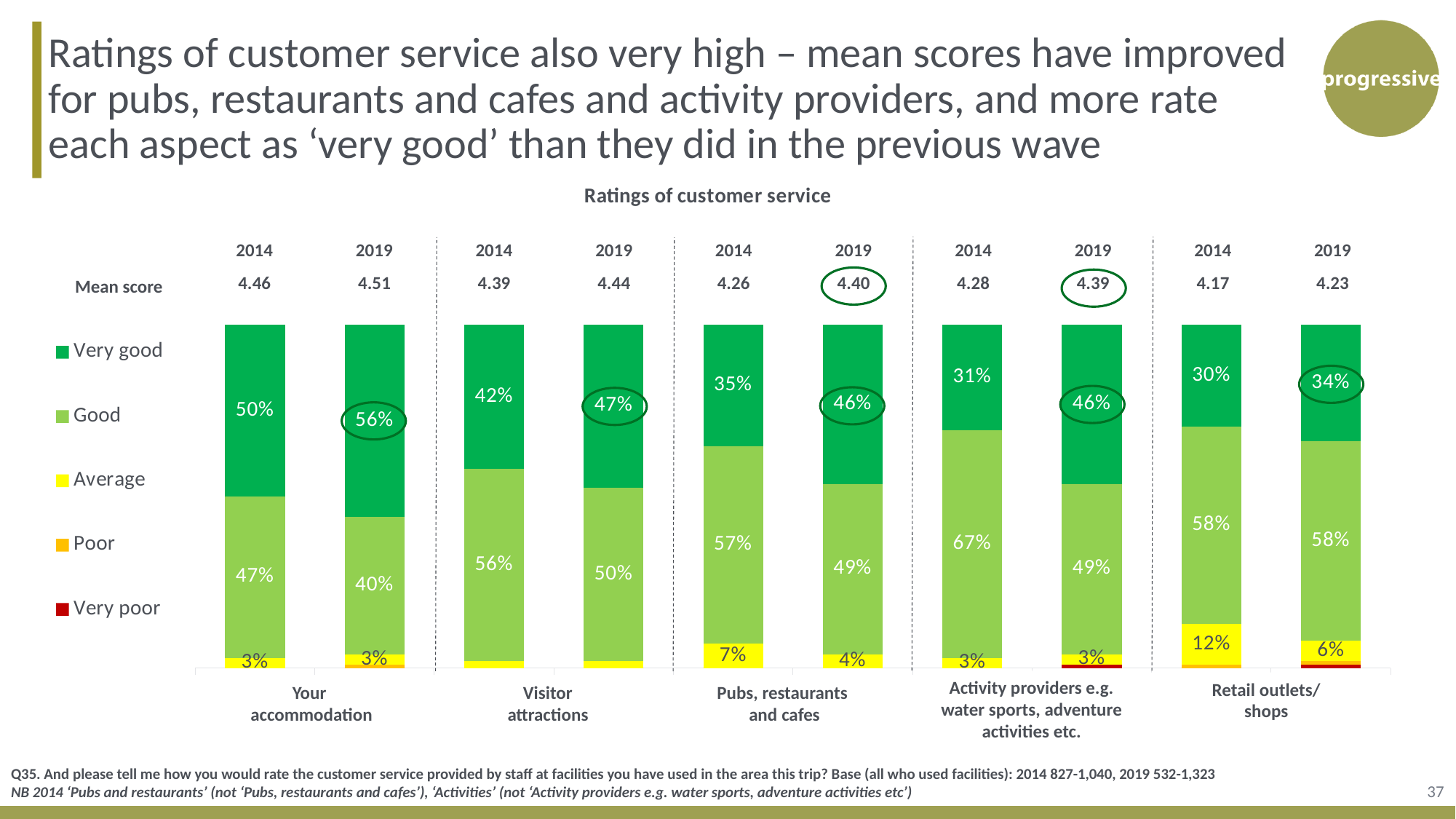
Which has a larger 'Good' share in 2014: 'Activity providers' or 'Retail outlets/ shops'? Activity providers (67%) What type of chart is shown? Stacked bar chart Does the 'Very good' share rise or fall from 2014 to 2019 for each facility type? Rises What percentage rated 'Pubs, restaurants and cafes' as 'Good' in 2014? 57% Which bar has the highest 'Very good' percentage? Your accommodation, 2019 (56%) How many facility types are shown on the x axis? 5 Which bar has the lowest mean score? Retail outlets/ shops, 2014 (4.17) What percentage rated customer service at 'Your accommodation' as 'Very good' in 2019? 56% How many rating categories does the legend list? 5 By how many percentage points did the 'Very good' share for 'Visitor attractions' change from 2014 to 2019? 5 percentage points (42% to 47%) What is the 'Average' share for 'Retail outlets/ shops' in 2014? 12% What is the mean score for 'Pubs, restaurants and cafes' in 2019? 4.40